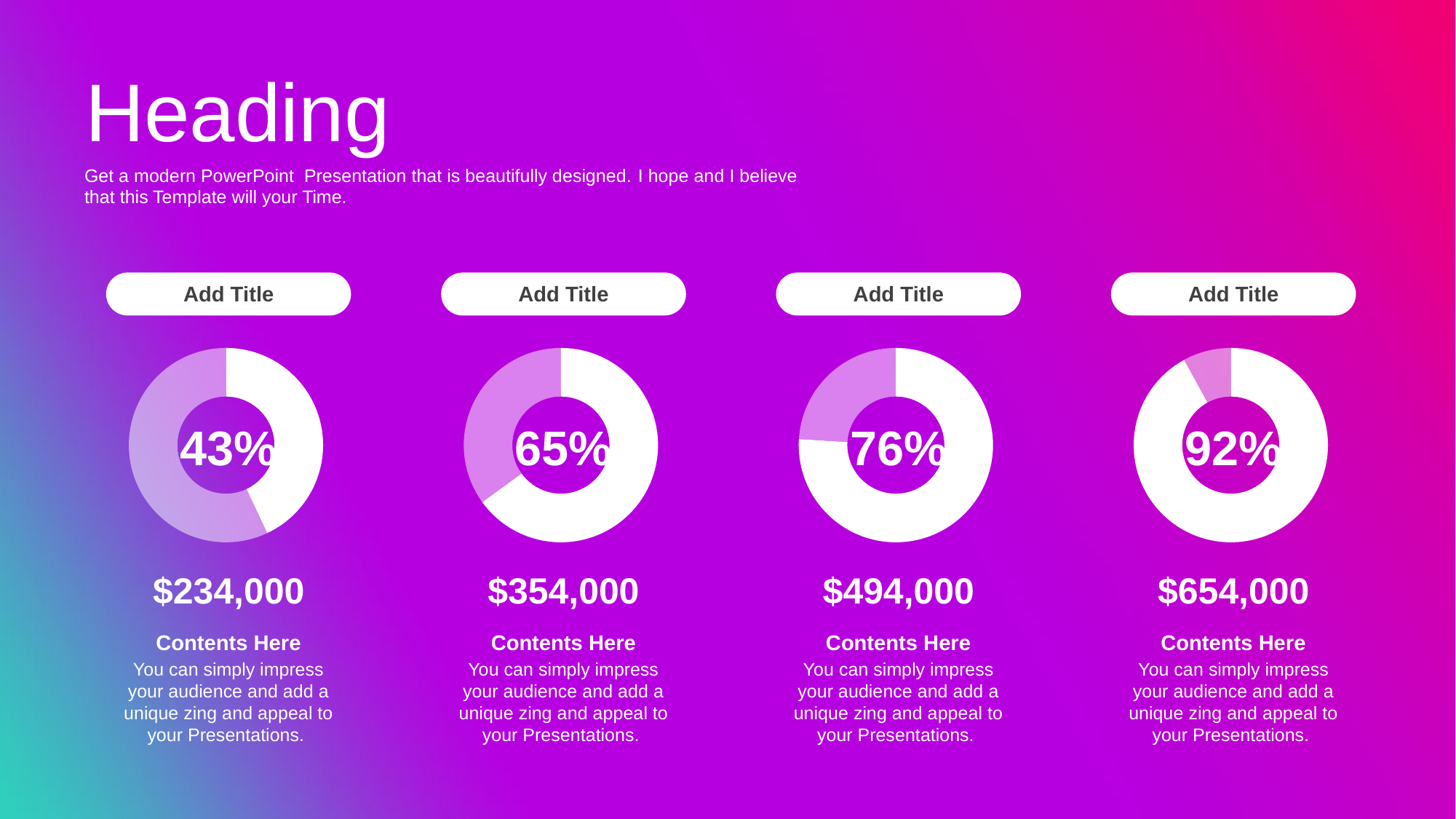
What kind of chart is used to display the percentages on the slide? Donut chart What percentage is shown in the center of the third donut chart from the left? 76% How many donut charts are on the slide? 4 What dollar value is printed below the donut chart showing 76%? $494,000 What percentage is shown in the center of the rightmost donut chart? 92% What is the difference between the percentage in the rightmost donut chart and the percentage in the leftmost donut chart? 49% Which is larger: the percentage in the second donut chart from the left or the percentage in the third donut chart from the left? The third (76%) Which donut chart shows the highest percentage? The rightmost one (92%) Do the percentages in the donut charts rise or fall from left to right across the slide? Rise Which donut chart shows the lowest percentage? The leftmost one (43%) What percentage is shown in the center of the leftmost donut chart? 43% What percentage is shown in the center of the second donut chart from the left? 65%